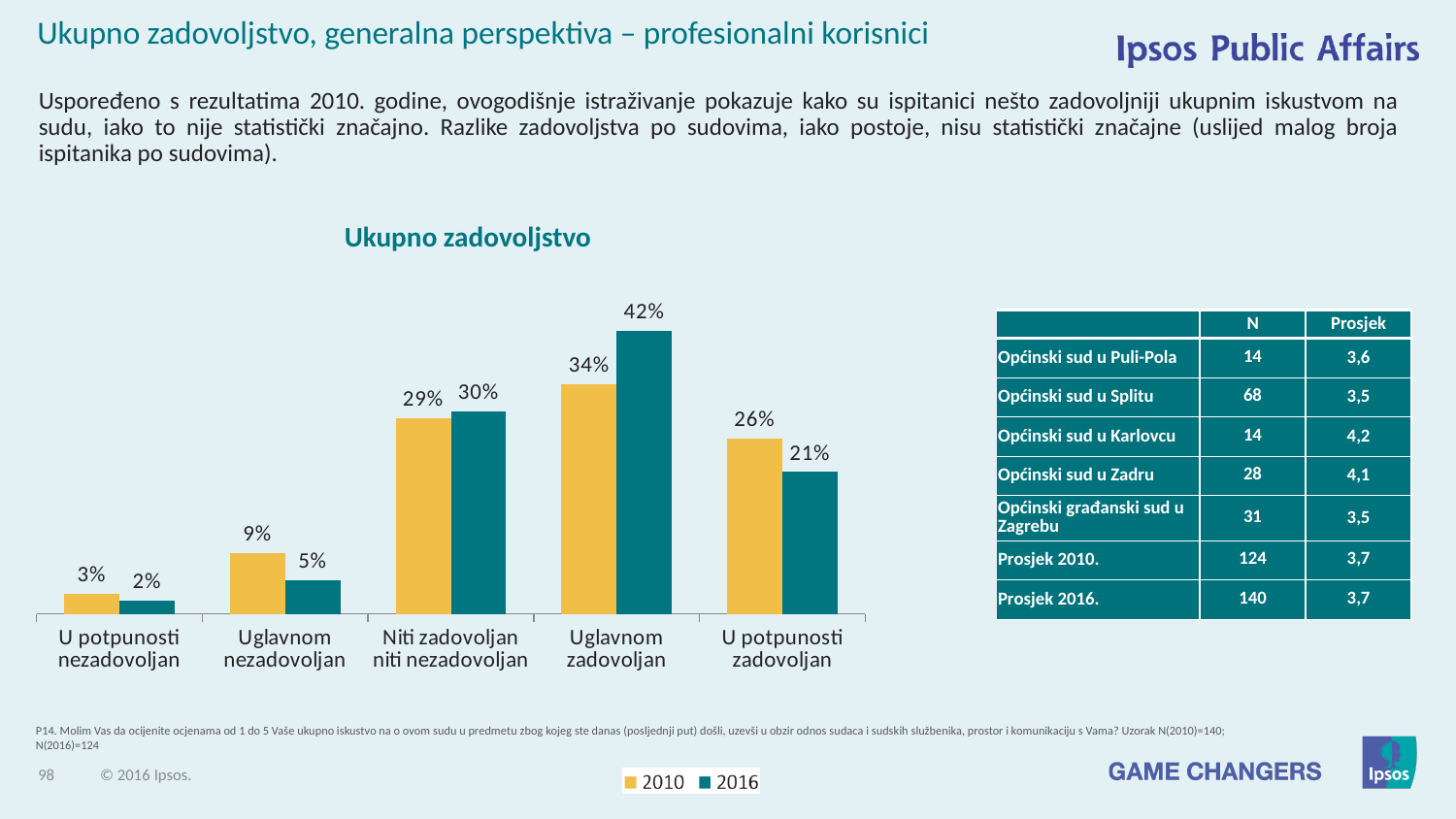
How many categories are shown on the x axis of the Ukupno zadovoljstvo chart? 5 What is the 2016 value for "Uglavnom zadovoljan" in the Ukupno zadovoljstvo chart? 42% Which category has the highest 2016 value in the Ukupno zadovoljstvo chart? Uglavnom zadovoljan What type of chart is the Ukupno zadovoljstvo chart? Bar chart How many series does the legend of the Ukupno zadovoljstvo chart list? 2 What is the difference between the 2010 and 2016 values for "U potpunosti zadovoljan" in the Ukupno zadovoljstvo chart? 5% What is the difference between the 2016 and 2010 values for "Uglavnom zadovoljan" in the Ukupno zadovoljstvo chart? 8% Which category has the lowest 2010 value in the Ukupno zadovoljstvo chart? U potpunosti nezadovoljan What is the 2016 value for "Uglavnom nezadovoljan" in the Ukupno zadovoljstvo chart? 5% What is the 2010 value for "U potpunosti zadovoljan" in the Ukupno zadovoljstvo chart? 26% In the Ukupno zadovoljstvo chart, which is larger for "Uglavnom nezadovoljan": the 2010 value or the 2016 value? 2010 Which colour represents the 2016 series in the Ukupno zadovoljstvo chart? Teal